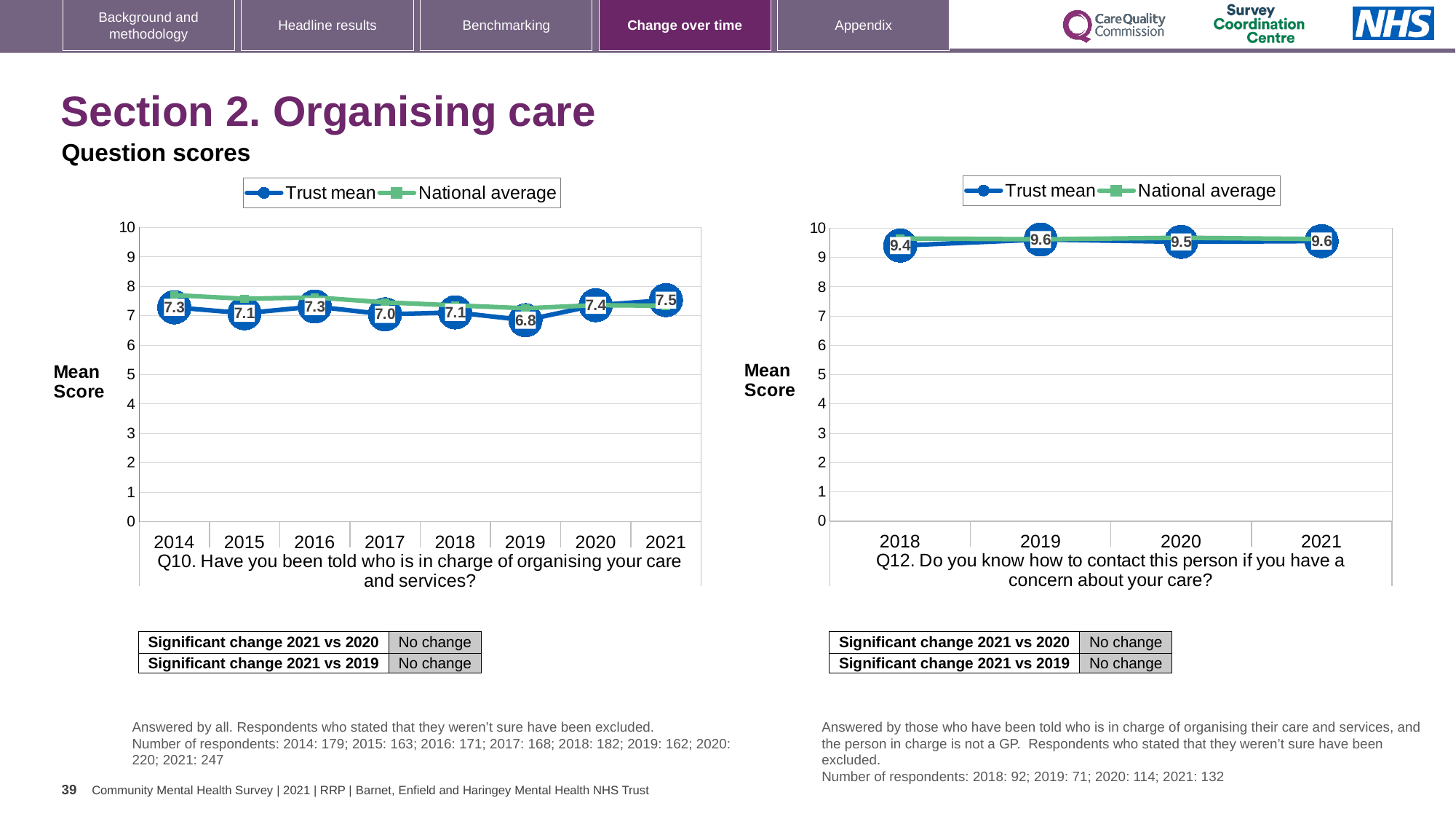
In the Q12 chart, is the Trust mean score higher in 2018 or 2019? 2019 In the Q10 chart, what is the Trust mean score for 2019? 6.8 In the Q12 chart, which year has the lowest Trust mean score? 2018 How many series does the legend of the Q12 chart list? 2 In the Q10 chart, what is the Trust mean score for 2021? 7.5 What type of chart is the Q10 chart? Line chart In the Q10 chart, how many years are shown on the x axis? 8 In the Q12 chart, what is the Trust mean score for 2018? 9.4 In the Q10 chart, what is the difference between the Trust mean scores for 2021 and 2019? 0.7 In the Q10 chart, which year has the lowest Trust mean score? 2019 In the Q10 chart, is the National average for 2014 greater or less than 7? greater In the Q10 chart, which year has the highest Trust mean score? 2021